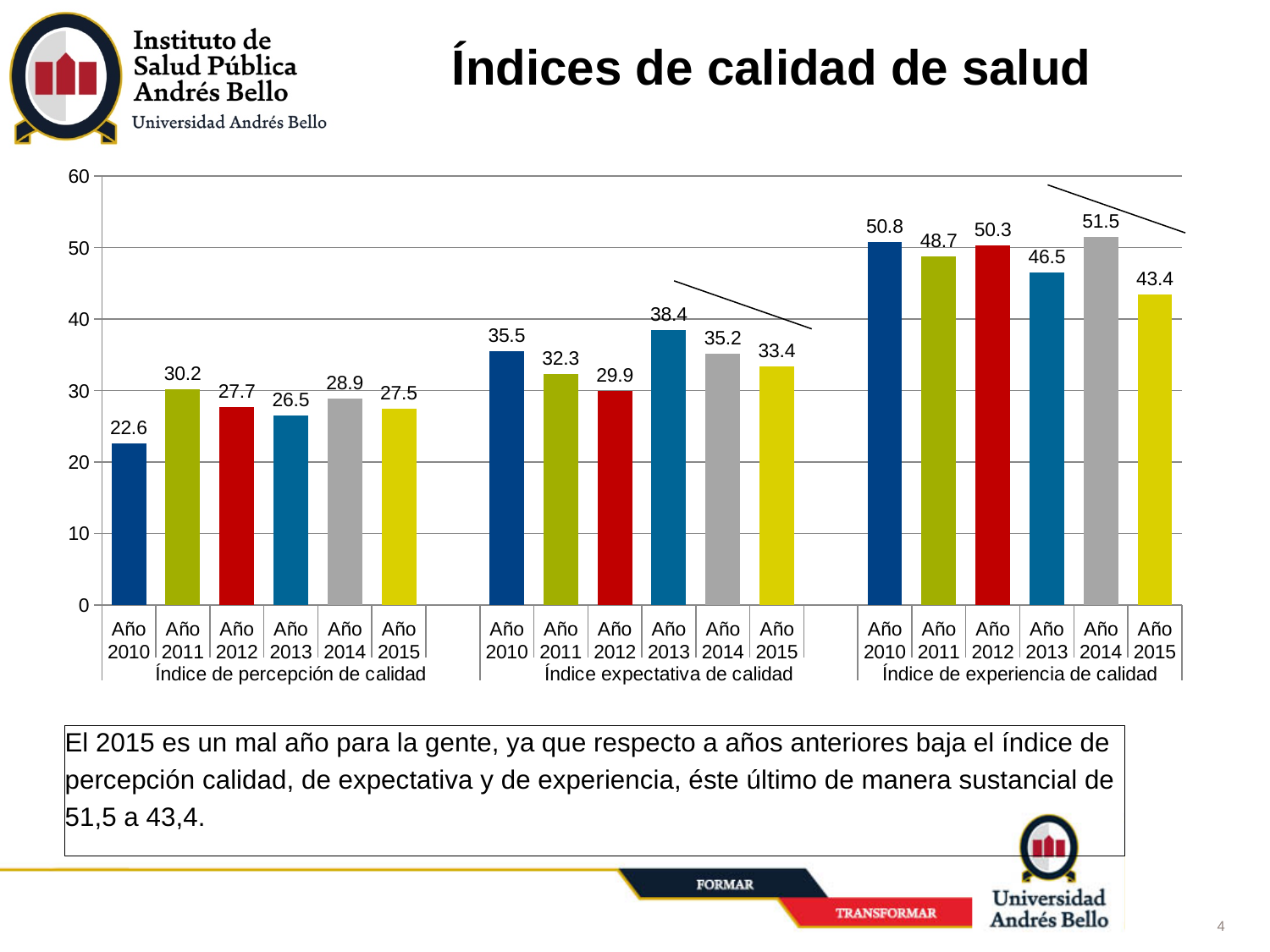
What is the difference between the Año 2014 and Año 2015 values in the Índice de experiencia de calidad group? 8.1 What is the title of the slide containing the chart? Índices de calidad de salud Which year has the lowest value in the Índice de percepción de calidad group? Año 2010 Is the value for Año 2015 in the Índice de experiencia de calidad group greater or less than 40? greater How many bars are plotted in the Índice expectativa de calidad group? 6 What kind of chart is shown on the slide? Bar chart Which is larger: the Año 2011 value or the Año 2012 value in the Índice expectativa de calidad group? Año 2011 What is the value for Año 2014 in the Índice de experiencia de calidad group? 51.5 What is the value for Año 2013 in the Índice expectativa de calidad group? 38.4 Which year has the highest value in the Índice de experiencia de calidad group? Año 2014 What is the value for Año 2010 in the Índice de percepción de calidad group? 22.6 Does the value fall or rise from Año 2014 to Año 2015 in the Índice de percepción de calidad group? Fall